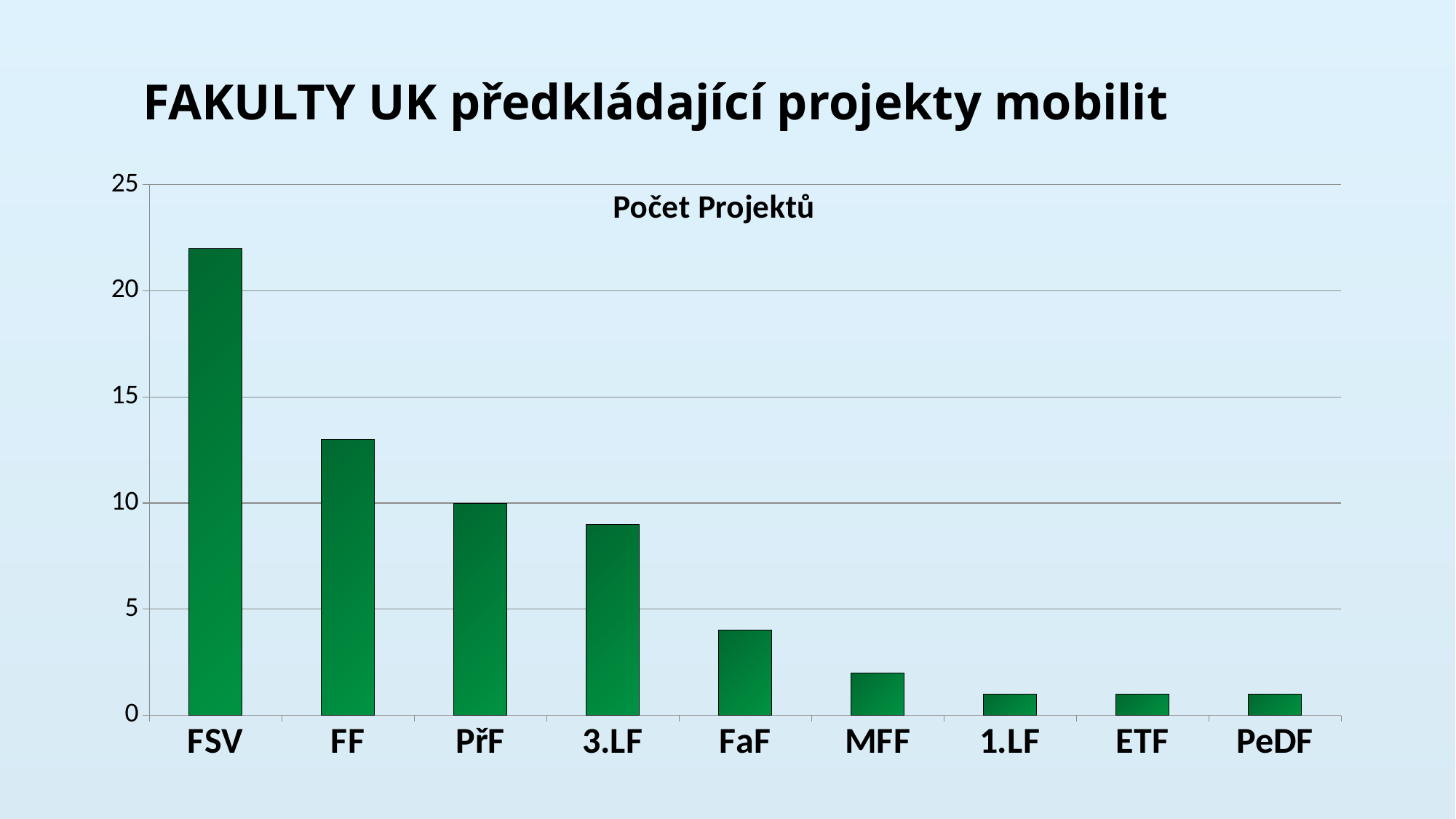
What is the title of the chart? Počet Projektů What is the value for PřF? 10 Is the value for FF greater or less than 15? less What type of chart is shown on the slide? bar chart Is the value for 3.LF greater or less than 10? less Which has a larger value, FF or 3.LF? FF What is the title of the slide? FAKULTY UK předkládající projekty mobilit Do the values rise or fall moving from left to right along the x axis? fall Is the value for FSV greater or less than 20? greater Which faculty has the highest number of projects? FSV How many faculties (categories) are shown on the x axis? 9